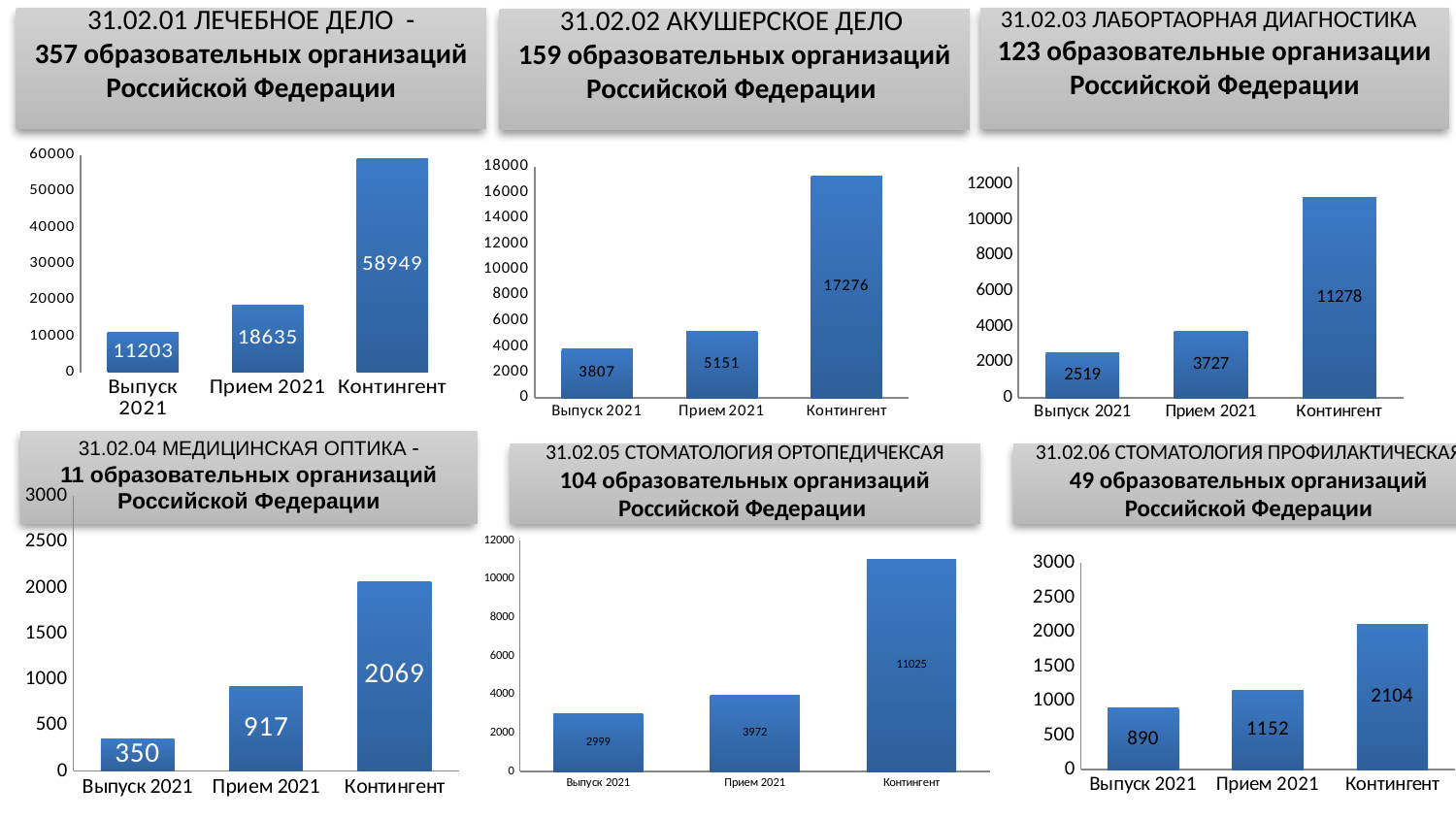
In the 31.02.06 СТОМАТОЛОГИЯ ПРОФИЛАКТИЧЕСКАЯ chart, what is the difference between Прием 2021 and Выпуск 2021? 262 In the 31.02.04 МЕДИЦИНСКАЯ ОПТИКА chart, which category has the lowest value? Выпуск 2021 What kind of chart is the 31.02.06 СТОМАТОЛОГИЯ ПРОФИЛАКТИЧЕСКАЯ chart? bar chart In the 31.02.02 АКУШЕРСКОЕ ДЕЛО chart, what is the value for Выпуск 2021? 3807 In the 31.02.02 АКУШЕРСКОЕ ДЕЛО chart, which is larger: Прием 2021 or Выпуск 2021? Прием 2021 In the 31.02.01 ЛЕЧЕБНОЕ ДЕЛО chart, what is the value for Контингент? 58949 In the 31.02.05 СТОМАТОЛОГИЯ ОРТОПЕДИЧЕКСАЯ chart, do the values rise or fall from Выпуск 2021 to Контингент? rise How many categories are shown in the 31.02.04 МЕДИЦИНСКАЯ ОПТИКА chart? 3 In the 31.02.03 ЛАБОРТАОРНАЯ ДИАГНОСТИКА chart, what is the value for Прием 2021? 3727 In the 31.02.01 ЛЕЧЕБНОЕ ДЕЛО chart, what is the difference between Контингент and Прием 2021? 40314 In the 31.02.03 ЛАБОРТАОРНАЯ ДИАГНОСТИКА chart, is the value for Контингент greater or less than 10000? greater In the 31.02.05 СТОМАТОЛОГИЯ ОРТОПЕДИЧЕКСАЯ chart, which category has the highest value? Контингент